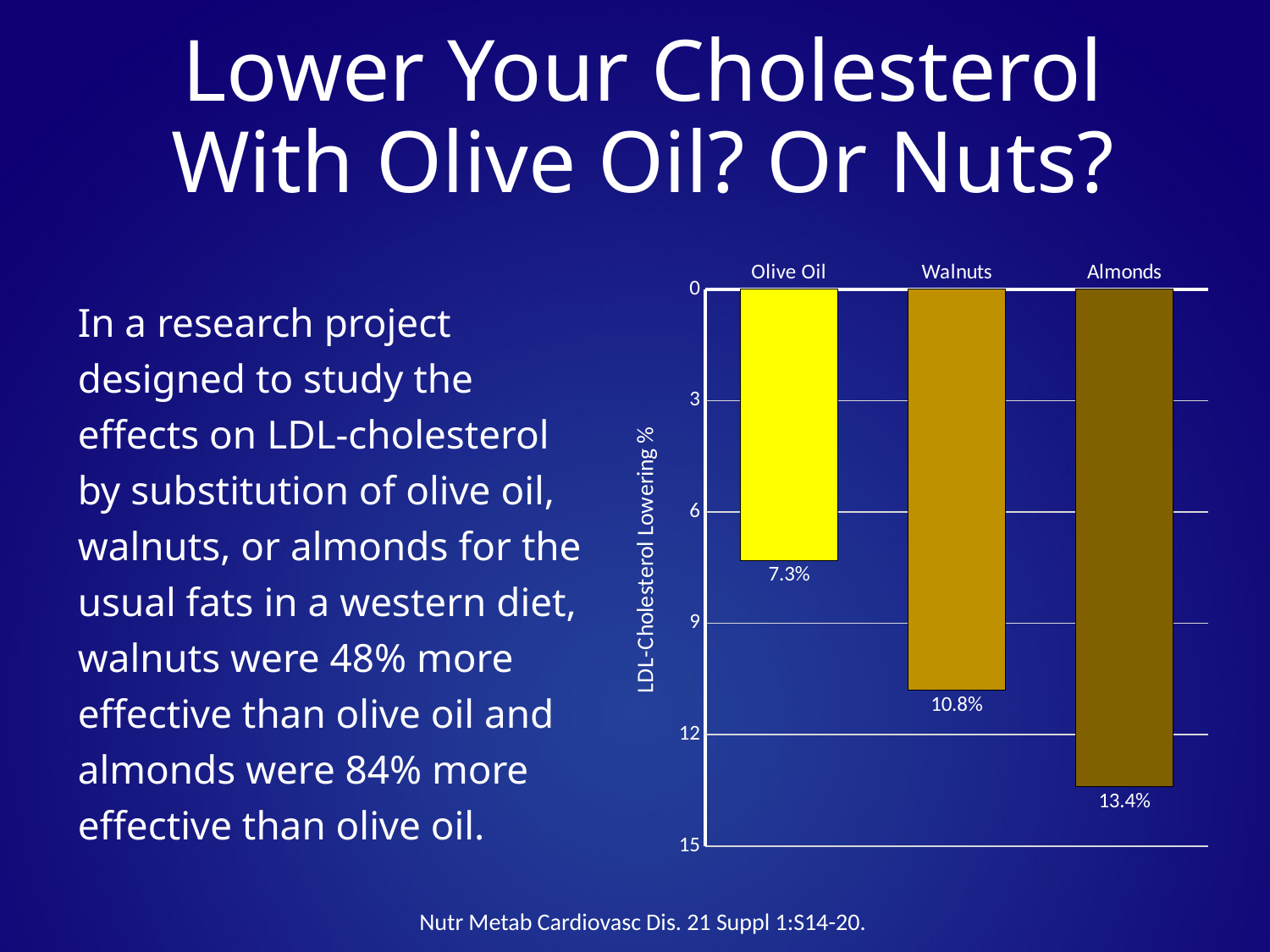
Is the value for Walnuts greater or less than 9? greater What is the LDL-cholesterol lowering value for Walnuts? 10.8% What is the label on the vertical axis of the chart? LDL-Cholesterol Lowering % How many categories are shown in the chart? 3 What is the LDL-cholesterol lowering value for Almonds? 13.4% What kind of chart is shown on the slide? Bar chart Which has a larger LDL-cholesterol lowering value, Walnuts or Almonds? Almonds What is the LDL-cholesterol lowering value for Olive Oil? 7.3% What is the difference between the LDL-cholesterol lowering values for Walnuts and Olive Oil? 3.5% What is the difference between the LDL-cholesterol lowering values for Almonds and Olive Oil? 6.1% Which category has the highest LDL-cholesterol lowering value? Almonds Which category has the lowest LDL-cholesterol lowering value? Olive Oil